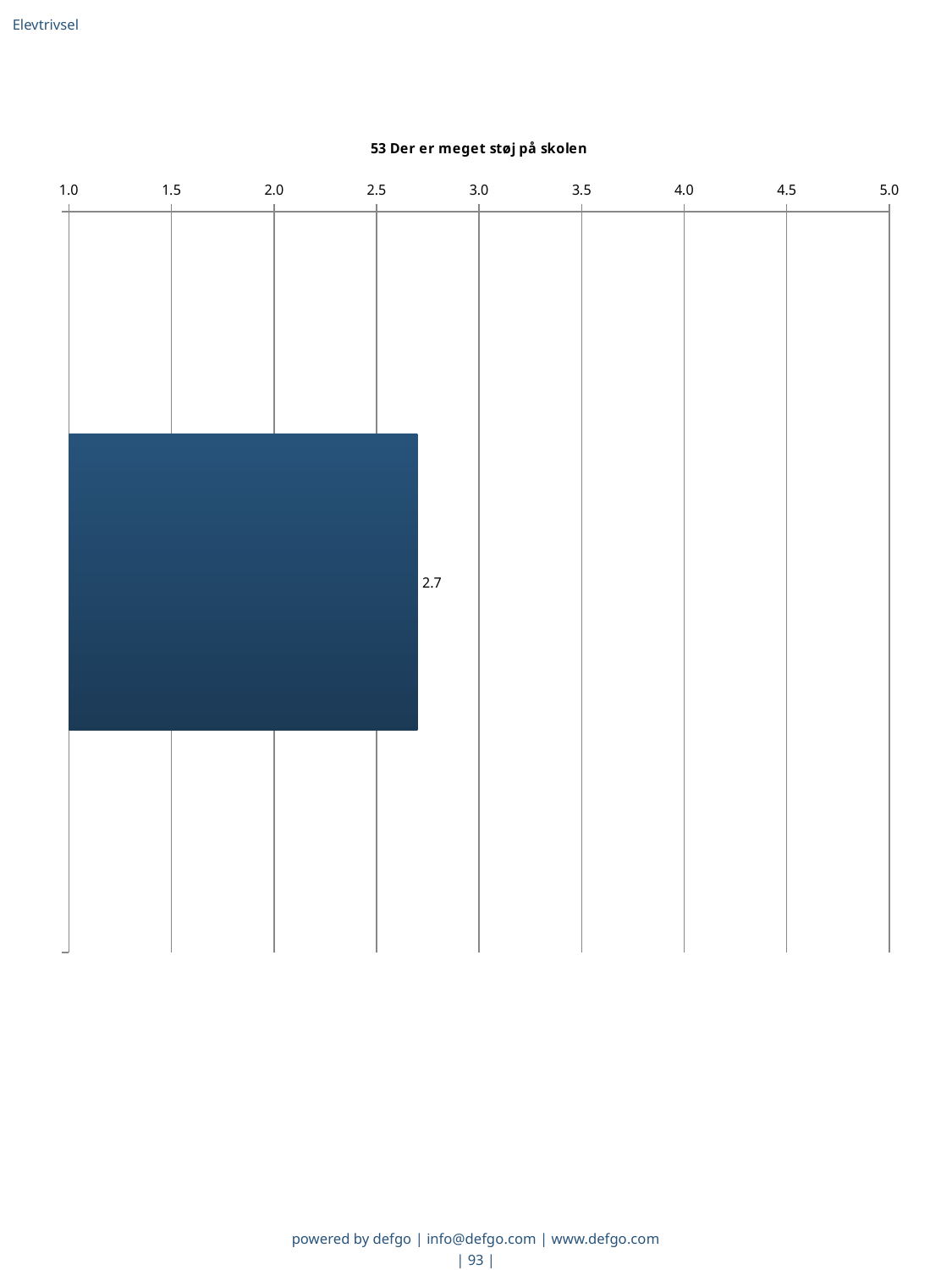
What kind of chart is shown on the slide? bar chart What is the maximum value shown on the chart's axis? 5.0 What is the value shown by the bar in the chart? 2.7 Is the bar in the chart horizontal or vertical? horizontal Is the value of the bar greater or less than 2.5? greater What is the title of the chart? 53 Der er meget støj på skolen How many bars are plotted in the chart? 1 Is the value of the bar greater or less than 3.0? less